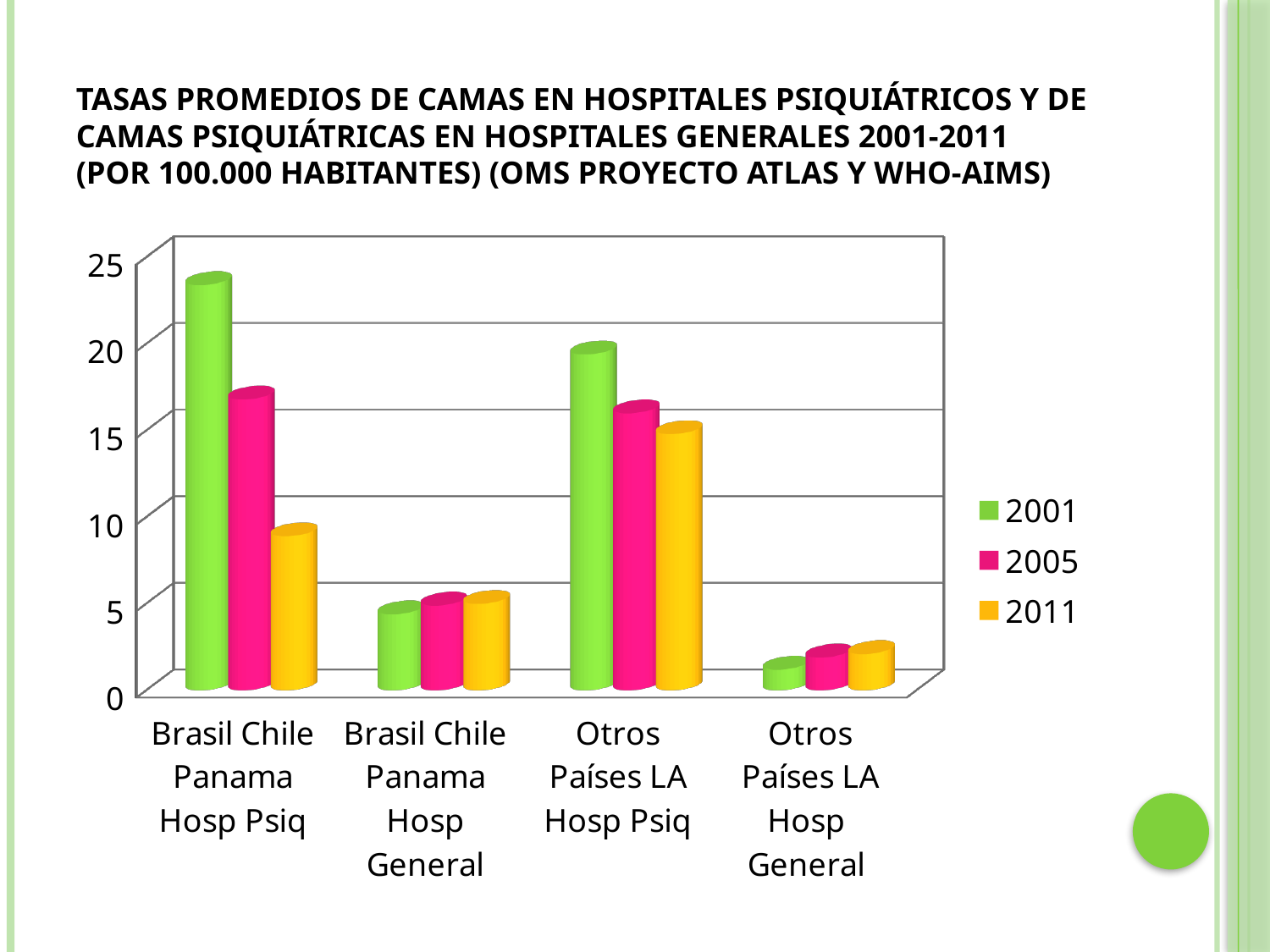
Is the 2001 value for Otros Países LA Hosp General greater or less than 5? less Do the values for Brasil Chile Panama Hosp Psiq rise or fall from 2001 to 2011? fall How many categories are shown on the x axis? 4 What kind of chart is shown on the slide? Bar chart Which colour represents the 2005 series in the legend? Pink Is the 2011 value for Brasil Chile Panama Hosp Psiq greater or less than 10? less Which is larger, the 2011 value for Brasil Chile Panama Hosp Psiq or the 2011 value for Otros Países LA Hosp Psiq? Otros Países LA Hosp Psiq Which is larger, the 2001 value for Brasil Chile Panama Hosp Psiq or the 2001 value for Otros Países LA Hosp Psiq? Brasil Chile Panama Hosp Psiq Which category and year has the highest bar in the chart? Brasil Chile Panama Hosp Psiq, 2001 Is the 2001 value for Brasil Chile Panama Hosp Psiq greater or less than 20? greater How many series does the legend list? 3 Which category and year has the lowest bar in the chart? Otros Países LA Hosp General, 2001